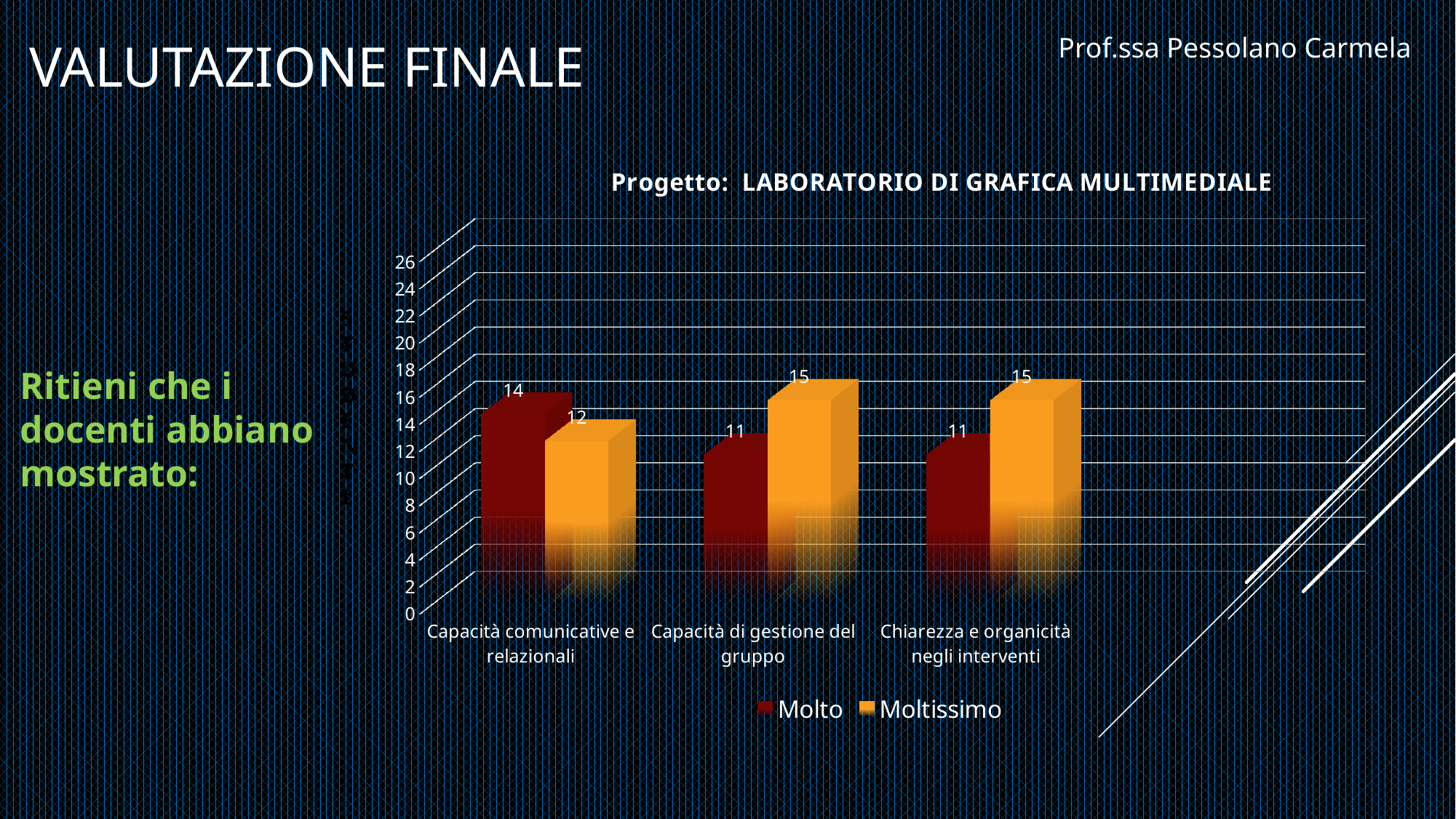
For 'Capacità comunicative e relazionali', which series has the larger value, Molto or Moltissimo? Molto How many categories are shown on the x axis of the chart? 3 What is the value for Moltissimo in the category 'Capacità di gestione del gruppo'? 15 What is the value for Molto in the category 'Capacità comunicative e relazionali'? 14 What kind of chart is shown on the slide? Bar chart What is the value for Molto in the category 'Chiarezza e organicità negli interventi'? 11 How many series does the chart legend list? 2 What is the title of the chart? Progetto: LABORATORIO DI GRAFICA MULTIMEDIALE In which category does the Molto series reach its highest value? Capacità comunicative e relazionali What is the value for Moltissimo in the category 'Capacità comunicative e relazionali'? 12 In which category does the Moltissimo series have its lowest value? Capacità comunicative e relazionali What is the difference between the Moltissimo and Molto values for 'Capacità di gestione del gruppo'? 4